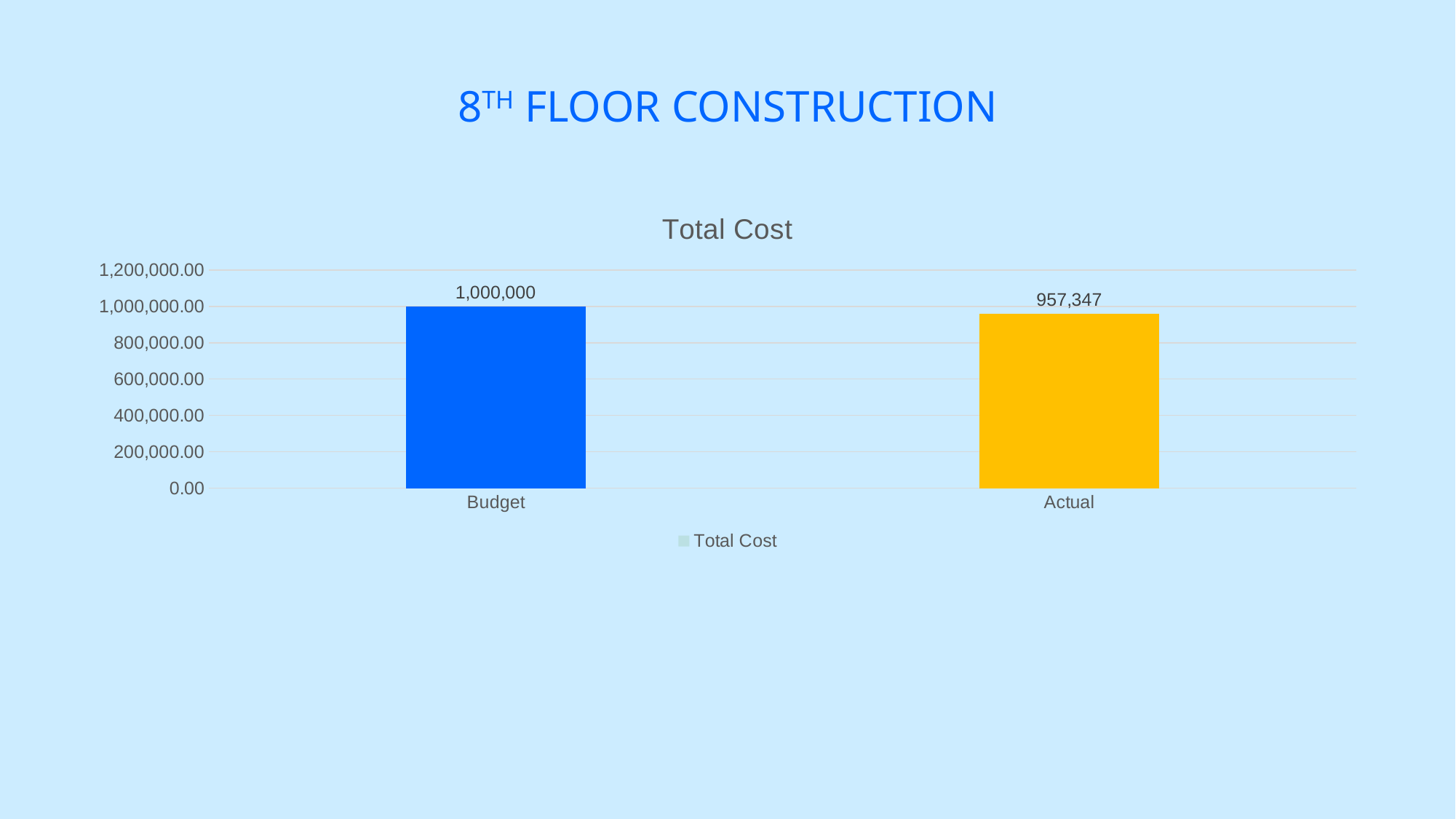
What is the value for Actual? 957,347 Which category has the highest value? Budget Which category has the lowest value? Actual What colour is the Actual bar? yellow What is the value for Budget? 1,000,000 How many series does the legend list? 1 Is the value for Actual greater or less than 1,000,000.00? less What is the difference between the Budget and Actual values? 42,653 What is the title of the chart? Total Cost What kind of chart is shown? bar chart Which is larger, Budget or Actual? Budget How many categories are shown on the x axis? 2